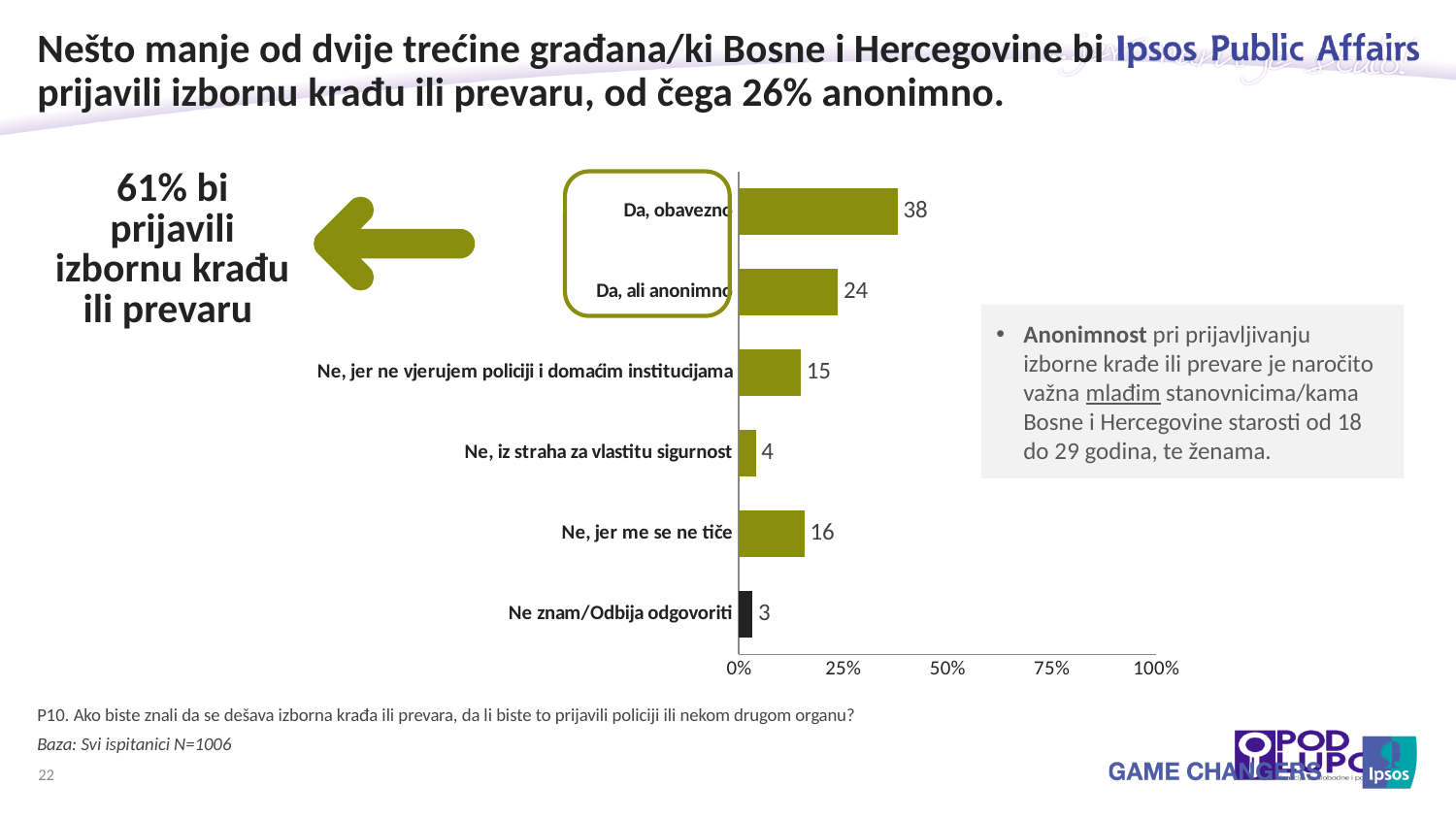
What is the difference between the values for "Da, obavezno" and "Da, ali anonimno"? 14 Is the value for "Da, obavezno" greater or less than 50%? less What value is shown for "Da, ali anonimno"? 24 What value is shown for "Da, obavezno"? 38 Which category has the lowest value? Ne znam/Odbija odgovoriti What value is shown for "Ne, jer ne vjerujem policiji i domaćim institucijama"? 15 Which is larger: the value for "Ne, jer me se ne tiče" or the value for "Ne, iz straha za vlastitu sigurnost"? Ne, jer me se ne tiče Which category has the highest value? Da, obavezno What is the total of the values for "Da, obavezno" and "Da, ali anonimno"? 62 How many categories are shown in the chart? 6 What value is shown for "Ne znam/Odbija odgovoriti"? 3 What kind of chart is shown on the slide? bar chart